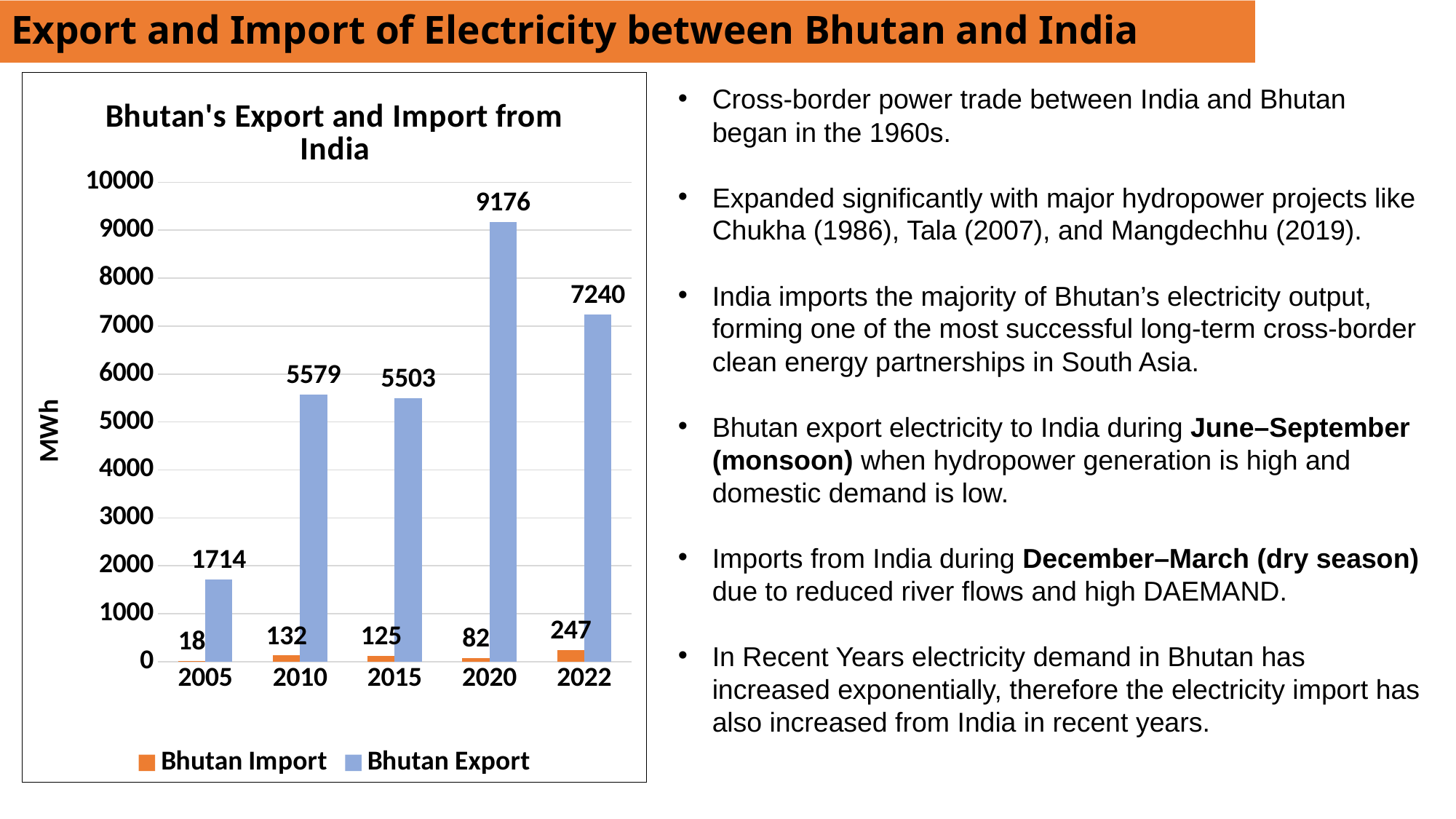
Which is larger, the Bhutan Export value for 2010 or for 2015? 2010 What kind of chart is shown on the slide? bar chart Is the Bhutan Export value for 2022 greater or less than 7000? greater What is the Bhutan Import value for 2022? 247 How many series does the legend list? 2 What is the difference between the Bhutan Export values for 2020 and 2022? 1936 What is the label on the vertical axis of the chart? MWh Which year has the highest Bhutan Export value? 2020 What is the Bhutan Export value for 2005? 1714 Which year has the lowest Bhutan Import value? 2005 How many years are shown on the x axis of the chart? 5 What is the Bhutan Export value for 2020? 9176